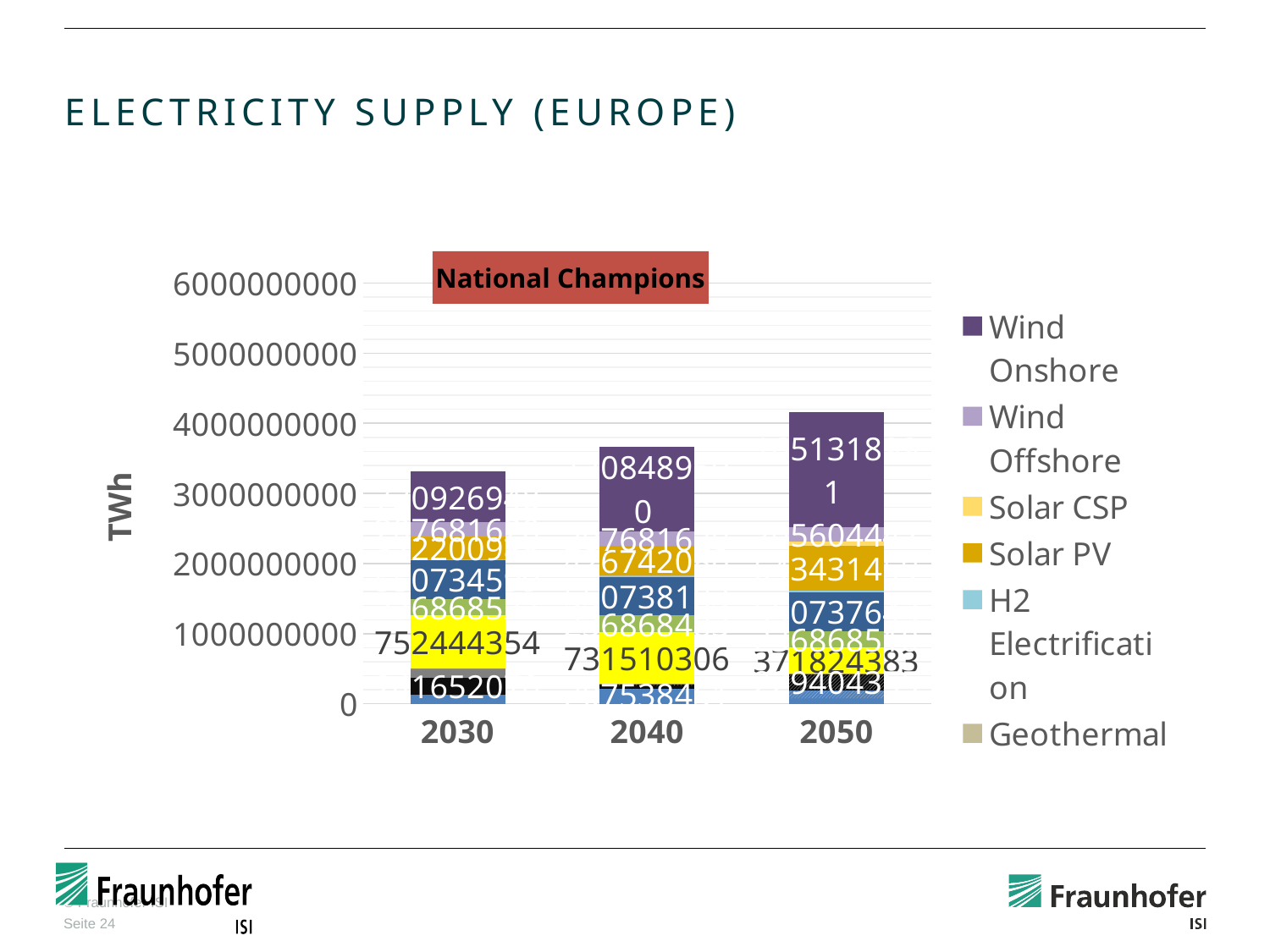
Is the total bar height for 2050 greater or less than 4000000000? greater Do the total bar heights rise or fall from 2030 to 2050? Rise What is the title of the chart on the slide? Electricity Supply (Europe) Which year has the shortest stacked bar? 2030 What kind of chart is shown on the slide? Stacked bar chart Is the total bar height for 2040 greater or less than 4000000000? less Is the total bar height for 2030 greater or less than 3000000000? greater Which year has the tallest stacked bar? 2050 How many years (categories) are shown on the x axis of the chart? 3 What unit is shown on the y axis label of the chart? TWh How many series does the chart legend list? 6 Which bar is taller, 2030 or 2050? 2050